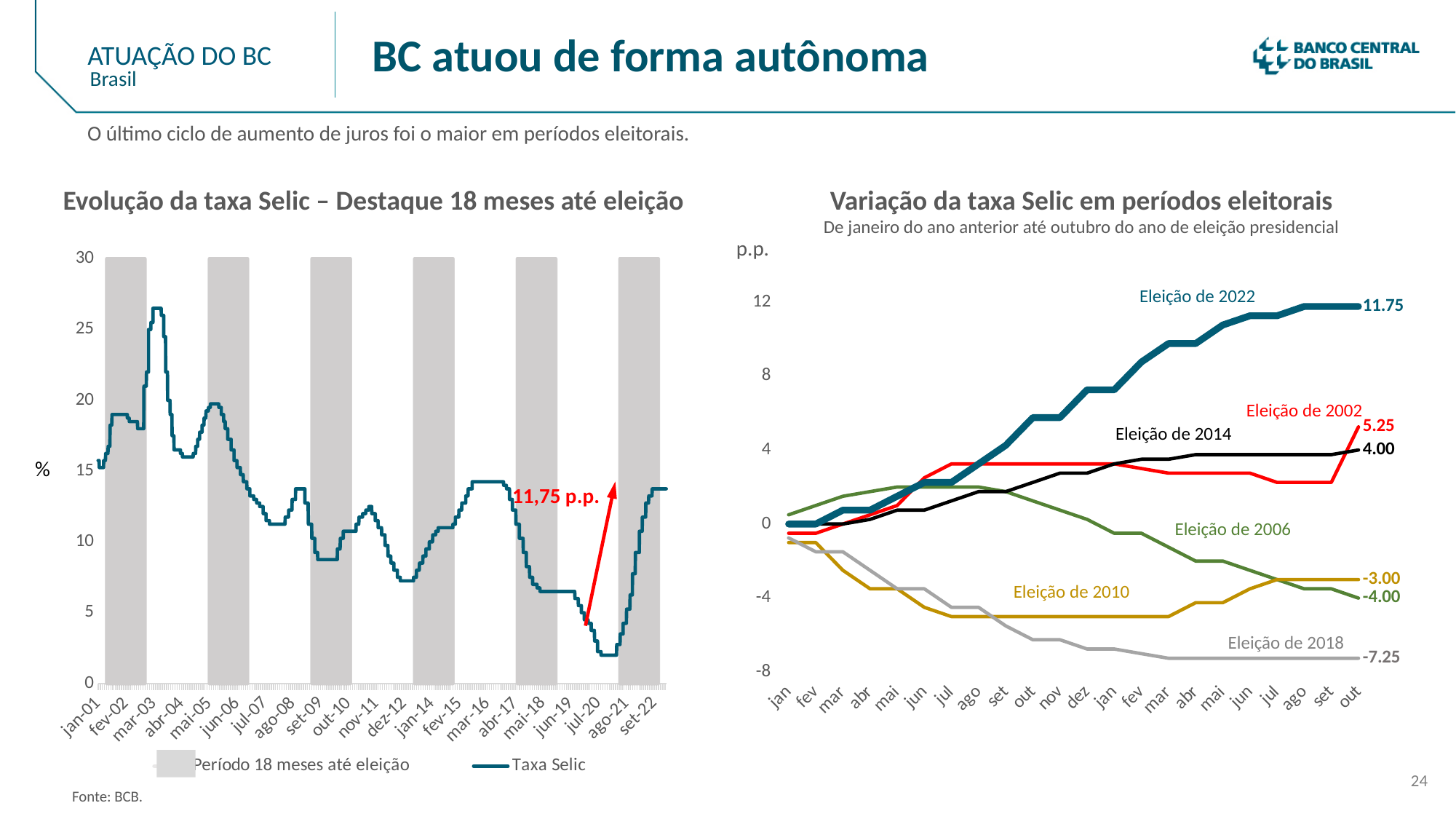
In the chart 'Variação da taxa Selic em períodos eleitorais', what is the difference between the final values of Eleição de 2022 and Eleição de 2002? 6.50 In the chart 'Evolução da taxa Selic – Destaque 18 meses até eleição', what value is written next to the red arrow? 11,75 p.p. How many election-period lines are plotted in the chart 'Variação da taxa Selic em períodos eleitorais'? 6 In the chart 'Variação da taxa Selic em períodos eleitorais', what is the final value shown for Eleição de 2010? -3.00 In the chart 'Variação da taxa Selic em períodos eleitorais', does the Eleição de 2018 line rise or fall from jan to out? fall In the chart 'Variação da taxa Selic em períodos eleitorais', which election period ends with the highest value? Eleição de 2022 In the chart 'Variação da taxa Selic em períodos eleitorais', what is the final value shown for Eleição de 2018? -7.25 How many entries does the legend of the chart 'Evolução da taxa Selic – Destaque 18 meses até eleição' list? 2 What kind of chart is 'Evolução da taxa Selic – Destaque 18 meses até eleição'? line chart In the chart 'Variação da taxa Selic em períodos eleitorais', what is the final value shown for Eleição de 2022? 11.75 In the chart 'Variação da taxa Selic em períodos eleitorais', which ends higher: Eleição de 2014 or Eleição de 2006? Eleição de 2014 In the chart 'Variação da taxa Selic em períodos eleitorais', which election period ends with the lowest value? Eleição de 2018